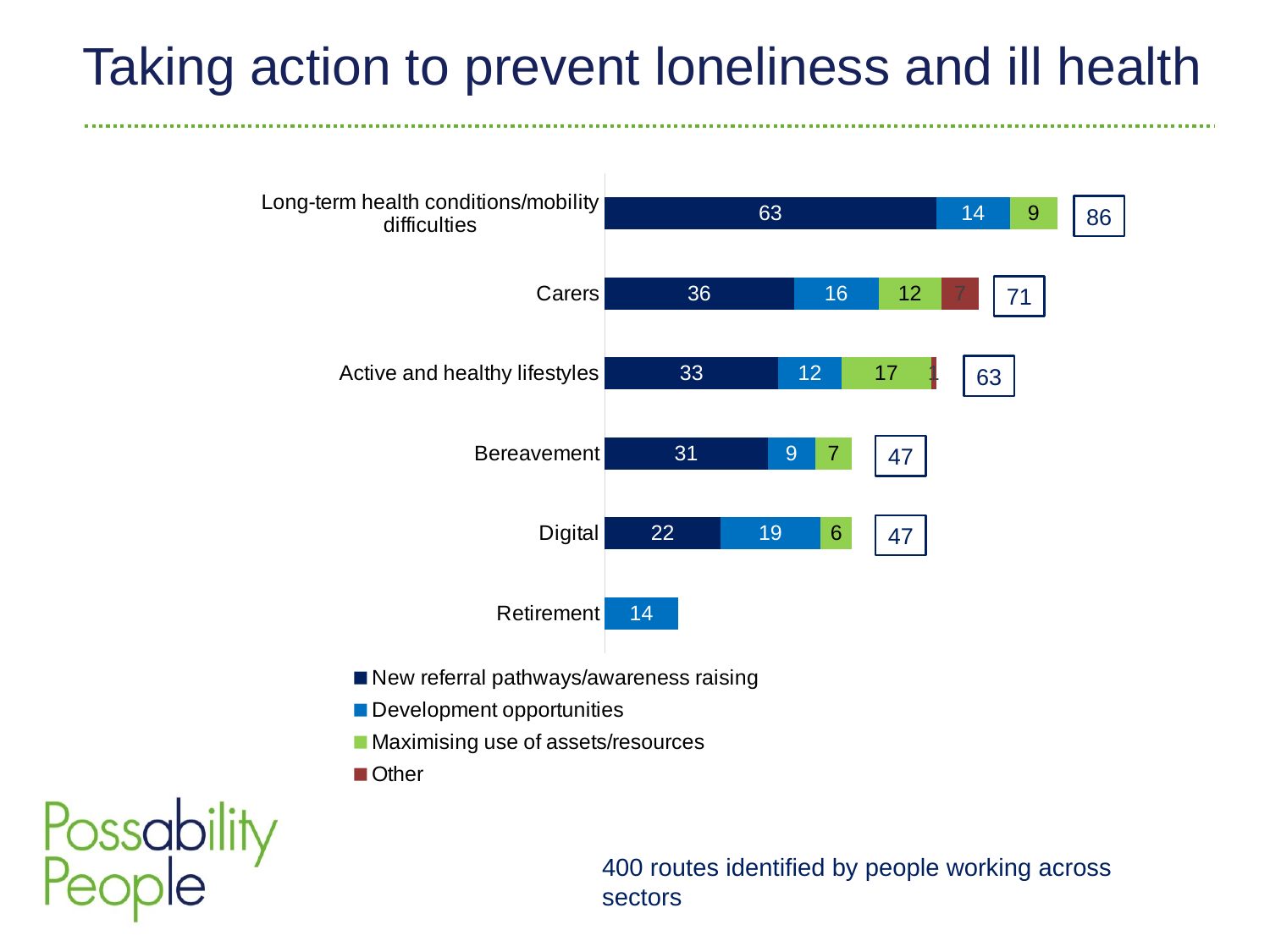
What is the total for the Long-term health conditions/mobility difficulties bar? 86 How many series does the legend list? 4 What is the value for Other for Carers? 7 What is the value for New referral pathways/awareness raising for Carers? 36 How many categories are shown on the chart? 6 What type of chart is shown on the slide? Stacked bar chart Which category has the lowest total? Retirement Which category has the highest total? Long-term health conditions/mobility difficulties What is the difference between the totals for Carers and Active and healthy lifestyles? 8 What is the value for Maximising use of assets/resources for Active and healthy lifestyles? 17 Which is larger: the New referral pathways/awareness raising value for Bereavement or for Digital? Bereavement What is the value for Development opportunities for Digital? 19